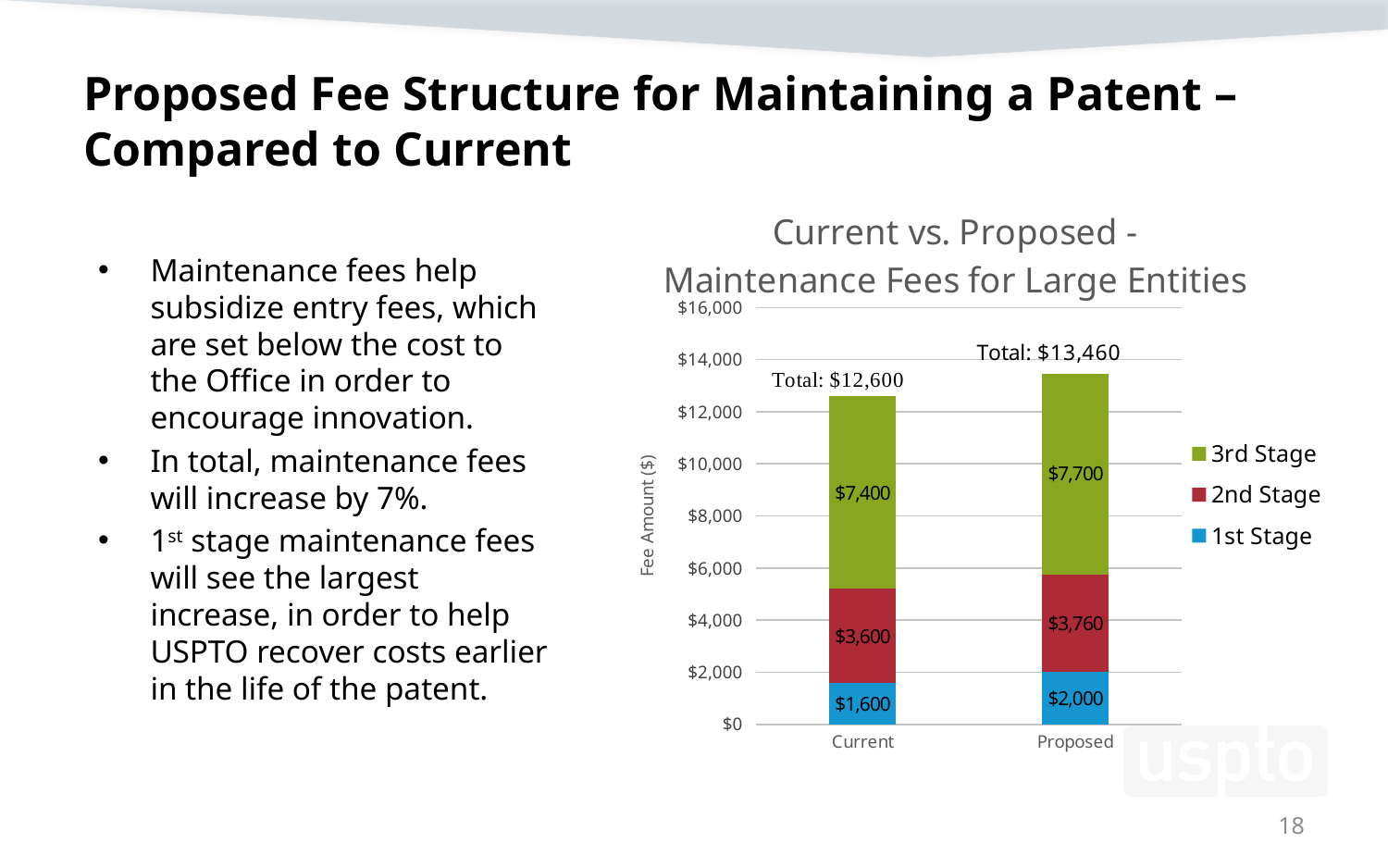
What is the 2nd Stage fee for the Proposed category? $3,760 Which stage has the highest fee in the Proposed bar? 3rd Stage What is the difference between the Proposed and Current 1st Stage fees? $400 What is the title of the chart? Current vs. Proposed - Maintenance Fees for Large Entities What is the 1st Stage fee for the Current category? $1,600 Which is larger, the 2nd Stage fee for Current or for Proposed? Proposed What is the total of the Proposed stacked bar? $13,460 How many series does the legend list? 3 What is the total of the Current stacked bar? $12,600 What is the difference between the Proposed and Current 3rd Stage fees? $300 What kind of chart is shown on the slide? Stacked bar chart What is the 3rd Stage fee for the Proposed category? $7,700